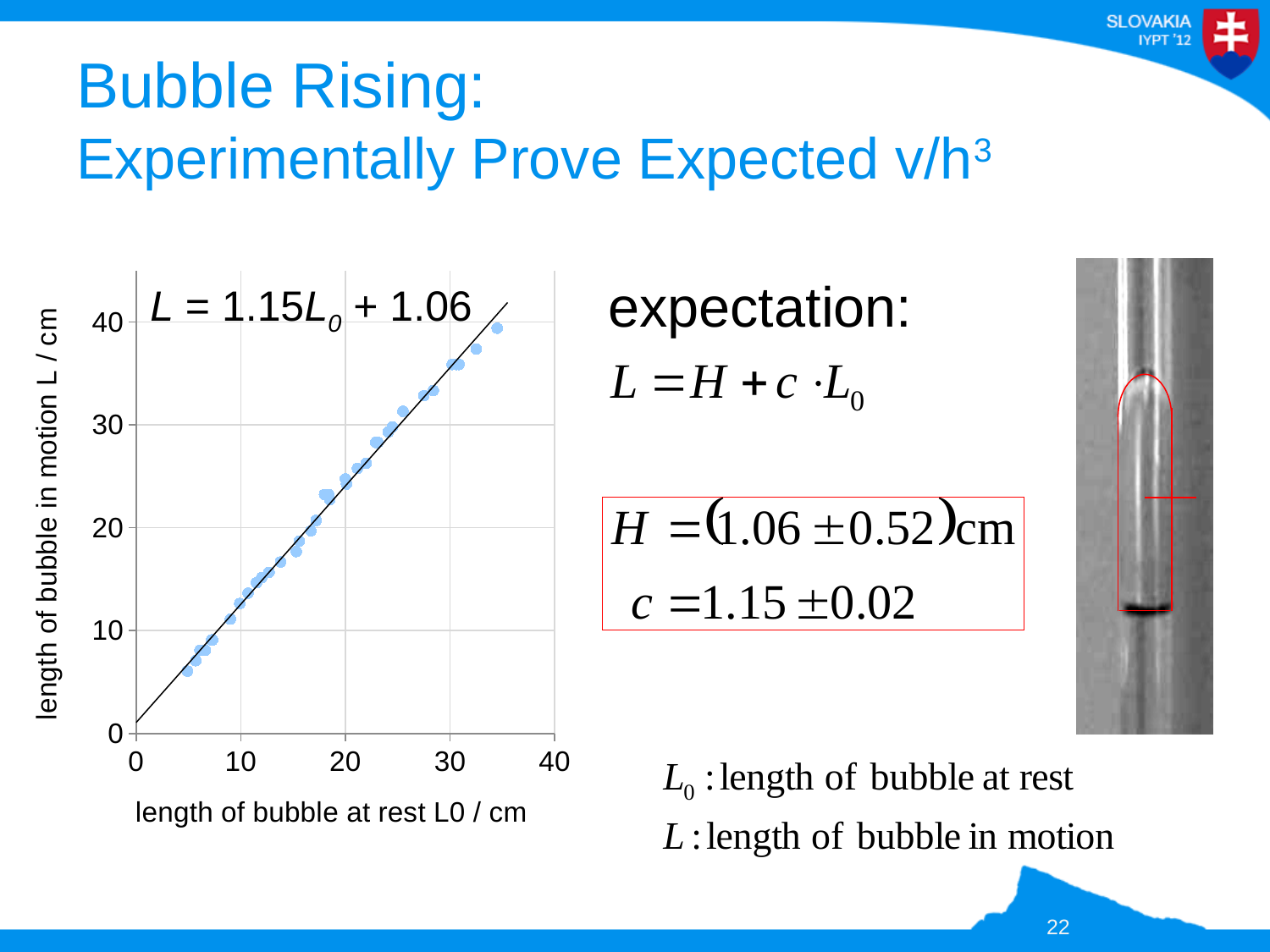
What kind of chart is shown on the slide? scatter chart Is the value of L for a bubble with L0 = 20 cm greater or less than 20? greater What is the label of the y axis of the chart? length of bubble in motion L / cm What is the intercept of the fitted line shown on the chart? 1.06 What is the label of the x axis of the chart? length of bubble at rest L0 / cm What is the highest tick value shown on the x axis of the chart? 40 Do the plotted values of L rise or fall as L0 increases along the x axis? rise Is the value of L for a bubble with L0 = 30 cm greater or less than 30? greater Is the value of L for a bubble with L0 = 10 cm greater or less than 10? greater What is the fitted line equation printed on the chart? L = 1.15L0 + 1.06 What is the slope of the fitted line shown on the chart? 1.15